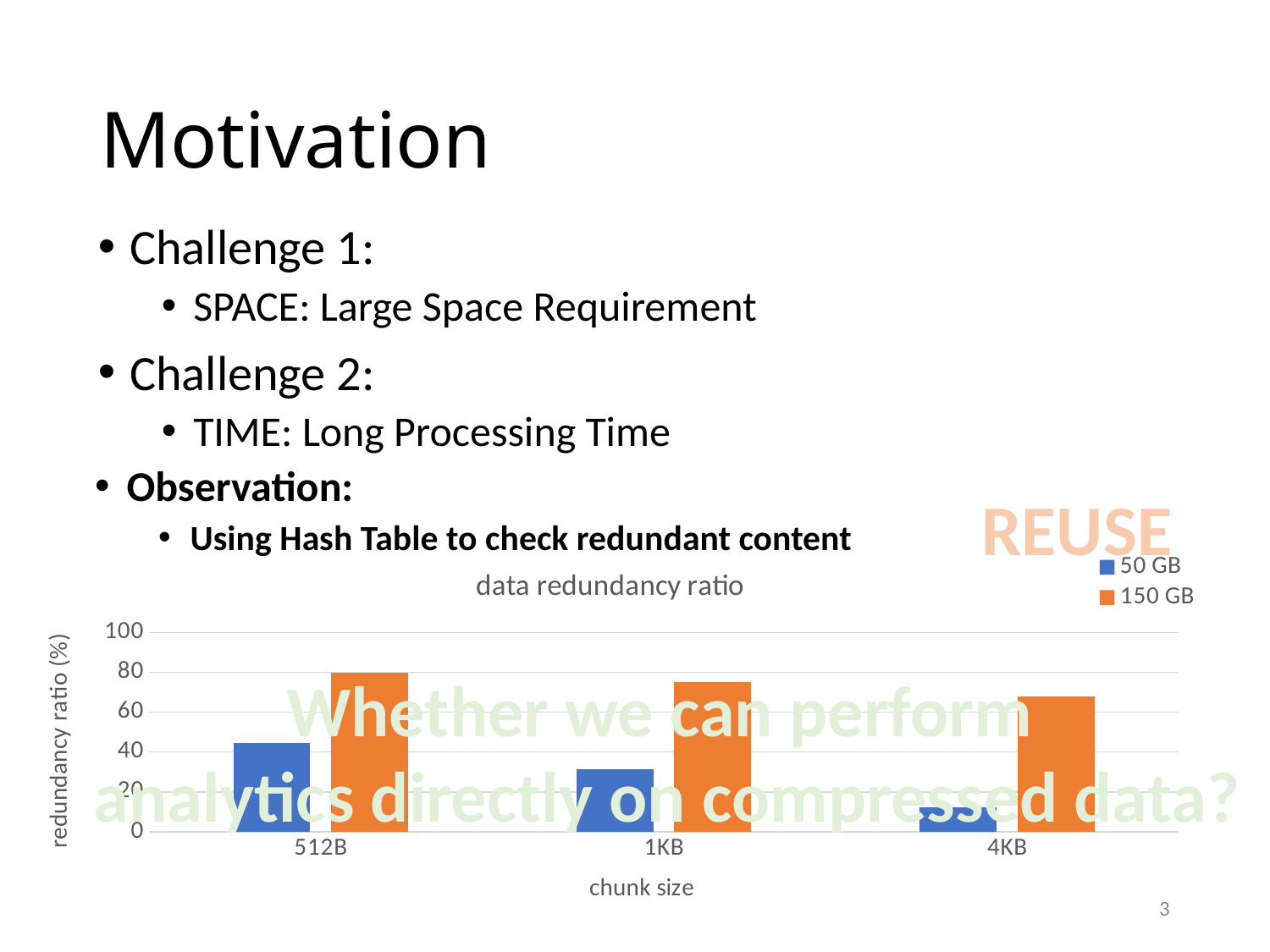
How many chunk size categories are shown on the x axis? 3 What is the title of the chart? data redundancy ratio Do the 50 GB values rise or fall as chunk size increases from 512B to 4KB? fall Is the 150 GB value for 512B greater or less than 60? greater Is the 50 GB value for 1KB greater or less than 20? greater How many series does the chart legend list? 2 What is the label of the x axis? chunk size What kind of chart is shown on the slide? bar chart For which chunk size is the 50 GB series lowest? 4KB Is the 150 GB value for 1KB greater or less than 60? greater At 512B, which series has the larger value, 50 GB or 150 GB? 150 GB